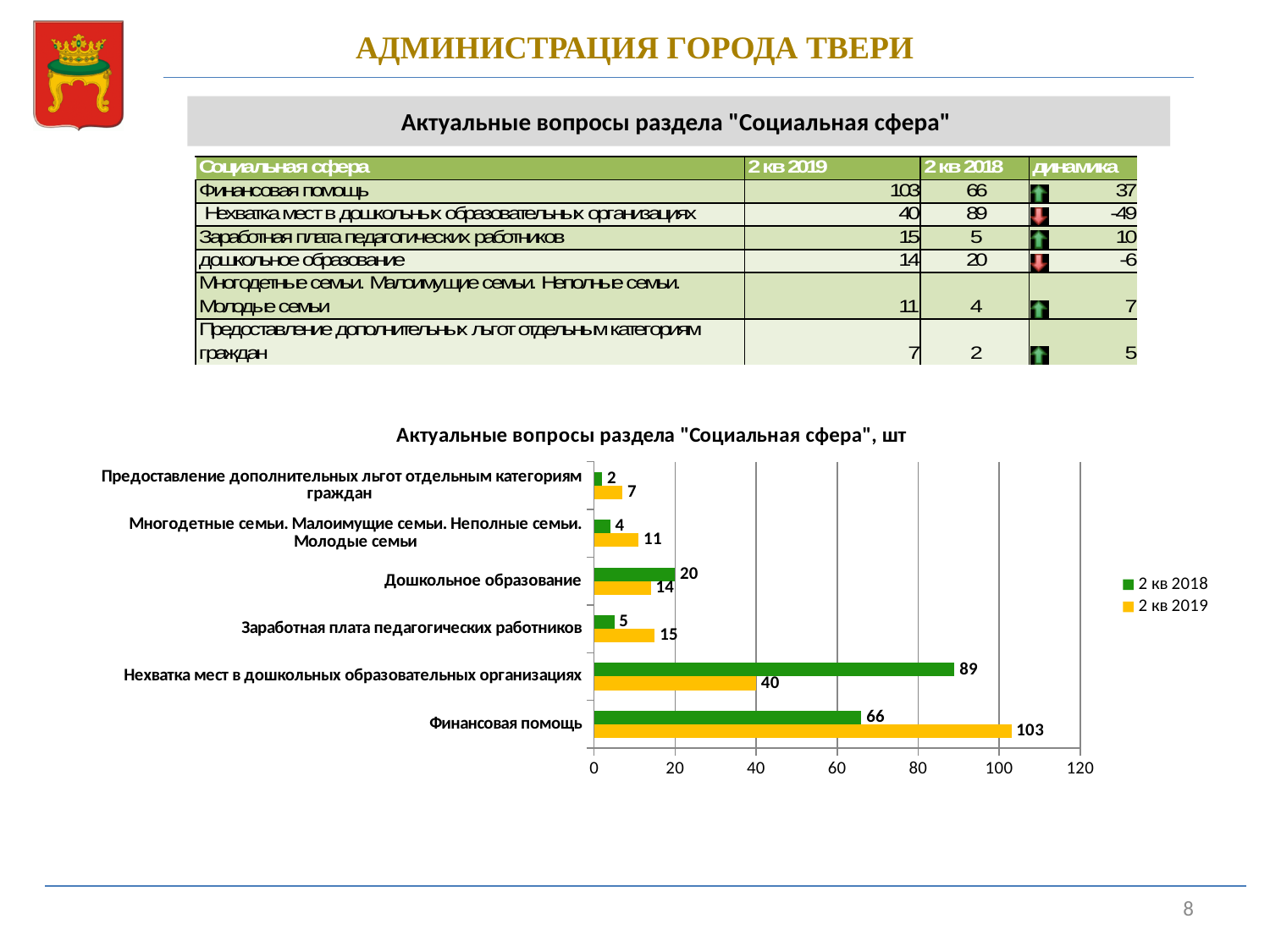
What type of chart is shown on the slide? bar chart Which is larger for Заработная плата педагогических работников: the 2 кв 2018 value or the 2 кв 2019 value? 2 кв 2019 What is the difference between the 2 кв 2018 and 2 кв 2019 values for Нехватка мест в дошкольных образовательных организациях? 49 How many series does the legend list? 2 What is the value for Нехватка мест в дошкольных образовательных организациях in 2 кв 2018? 89 What is the difference between the 2 кв 2019 and 2 кв 2018 values for Финансовая помощь? 37 Which category has the highest value in 2 кв 2019? Финансовая помощь What is the title of the chart? Актуальные вопросы раздела "Социальная сфера", шт What is the value for Финансовая помощь in 2 кв 2019? 103 What is the value for Дошкольное образование in 2 кв 2019? 14 Which category has the lowest value in 2 кв 2018? Предоставление дополнительных льгот отдельным категориям граждан How many categories are shown on the chart? 6